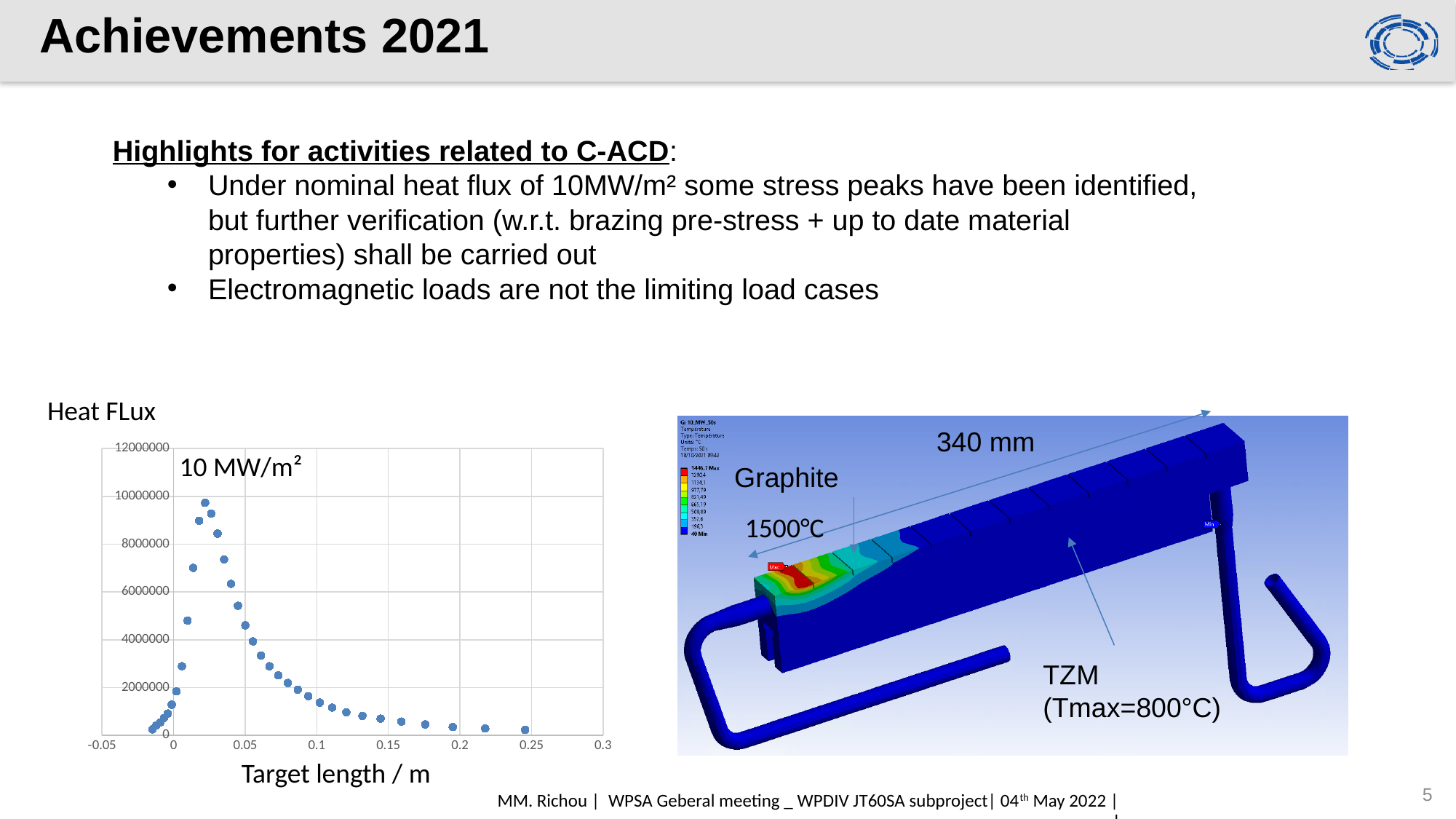
In the Heat FLux chart, is the heat flux at a target length of 0.05 m greater or less than 2000000? greater What is the highest tick value shown on the y axis of the Heat FLux chart? 12000000 What annotation text is printed inside the plot area of the Heat FLux chart? 10 MW/m² In the Heat FLux chart, is the heat flux at a target length of 0.05 m larger or smaller than at 0.2 m? larger In the Heat FLux chart, is the peak heat flux value greater or less than 10000000? less In the Heat FLux chart, is the heat flux at a target length of 0.15 m greater or less than 2000000? less In the Heat FLux chart, do the heat flux values rise or fall as target length increases from 0.05 m to 0.25 m? fall What kind of chart is the Heat FLux chart? scatter chart In the Heat FLux chart, is the heat flux at a target length of 0.1 m larger or smaller than at 0.05 m? smaller What is the label on the x axis of the Heat FLux chart? Target length / m